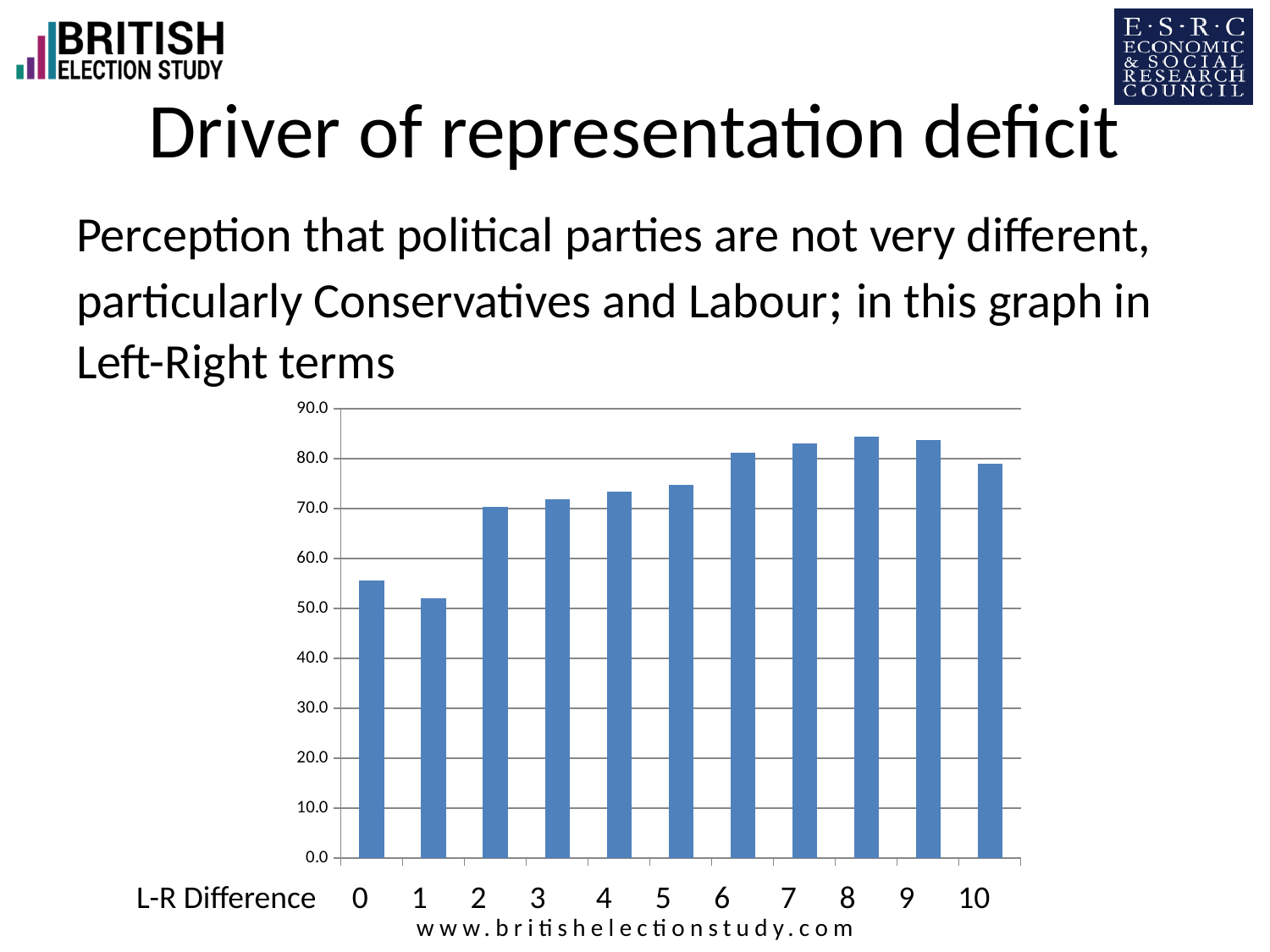
Which L-R Difference category has the lowest bar? 1 Is the value for L-R Difference 6 greater or less than 80.0? greater Is the value for L-R Difference 0 greater or less than 60.0? less How many bars (L-R Difference categories) are plotted in the chart? 11 What label is shown for the x axis of the chart? L-R Difference Which is larger, the value for L-R Difference 2 or L-R Difference 10? 10 Which is larger, the value for L-R Difference 0 or L-R Difference 1? 0 Is the value for L-R Difference 1 greater or less than 50.0? greater Do the values generally rise or fall from L-R Difference 1 to L-R Difference 8? rise What kind of chart is shown on the slide? bar chart